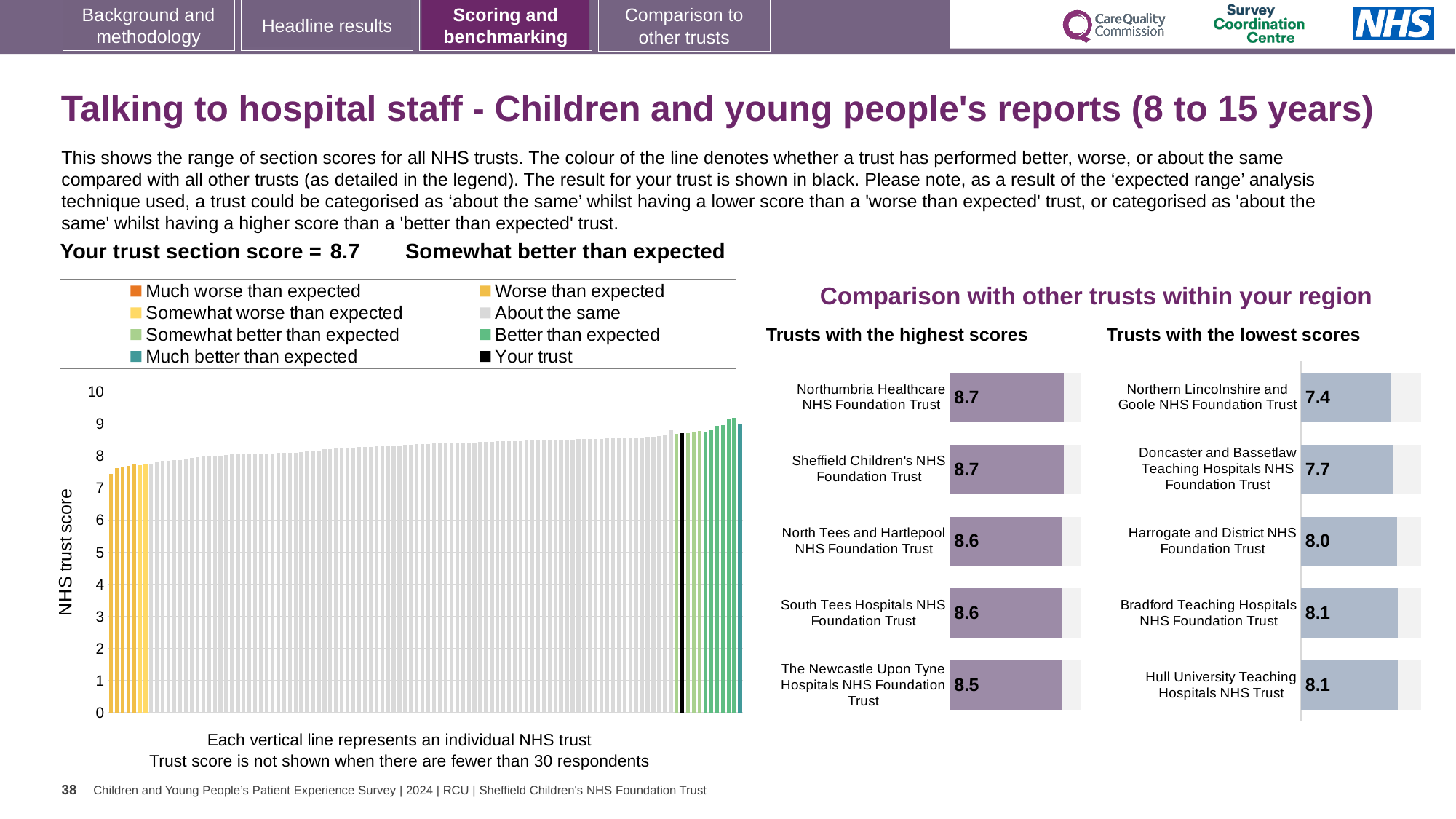
How many entries does the legend above the large chart on the left list? 8 In the large chart on the left, do the bar values rise or fall from left to right? rise In the large chart on the left, is the value for the black bar (Your trust) greater or less than 8? greater What kind of chart is the large chart on the left of the slide? bar chart In the 'Trusts with the lowest scores' chart, which has the higher score: Harrogate and District NHS Foundation Trust or Doncaster and Bassetlaw Teaching Hospitals NHS Foundation Trust? Harrogate and District NHS Foundation Trust In the 'Trusts with the lowest scores' chart, which trust has the lowest score? Northern Lincolnshire and Goole NHS Foundation Trust In the 'Trusts with the lowest scores' chart, what is the difference between the scores of Hull University Teaching Hospitals NHS Trust and Northern Lincolnshire and Goole NHS Foundation Trust? 0.7 In the 'Trusts with the highest scores' chart, what is the score for North Tees and Hartlepool NHS Foundation Trust? 8.6 In the 'Trusts with the highest scores' chart, which trust has the lowest score? The Newcastle Upon Tyne Hospitals NHS Foundation Trust How many trusts are listed in the 'Trusts with the highest scores' chart? 5 In the 'Trusts with the highest scores' chart, what is the difference between the scores of Northumbria Healthcare NHS Foundation Trust and The Newcastle Upon Tyne Hospitals NHS Foundation Trust? 0.2 In the 'Trusts with the lowest scores' chart, what is the score for Doncaster and Bassetlaw Teaching Hospitals NHS Foundation Trust? 7.7